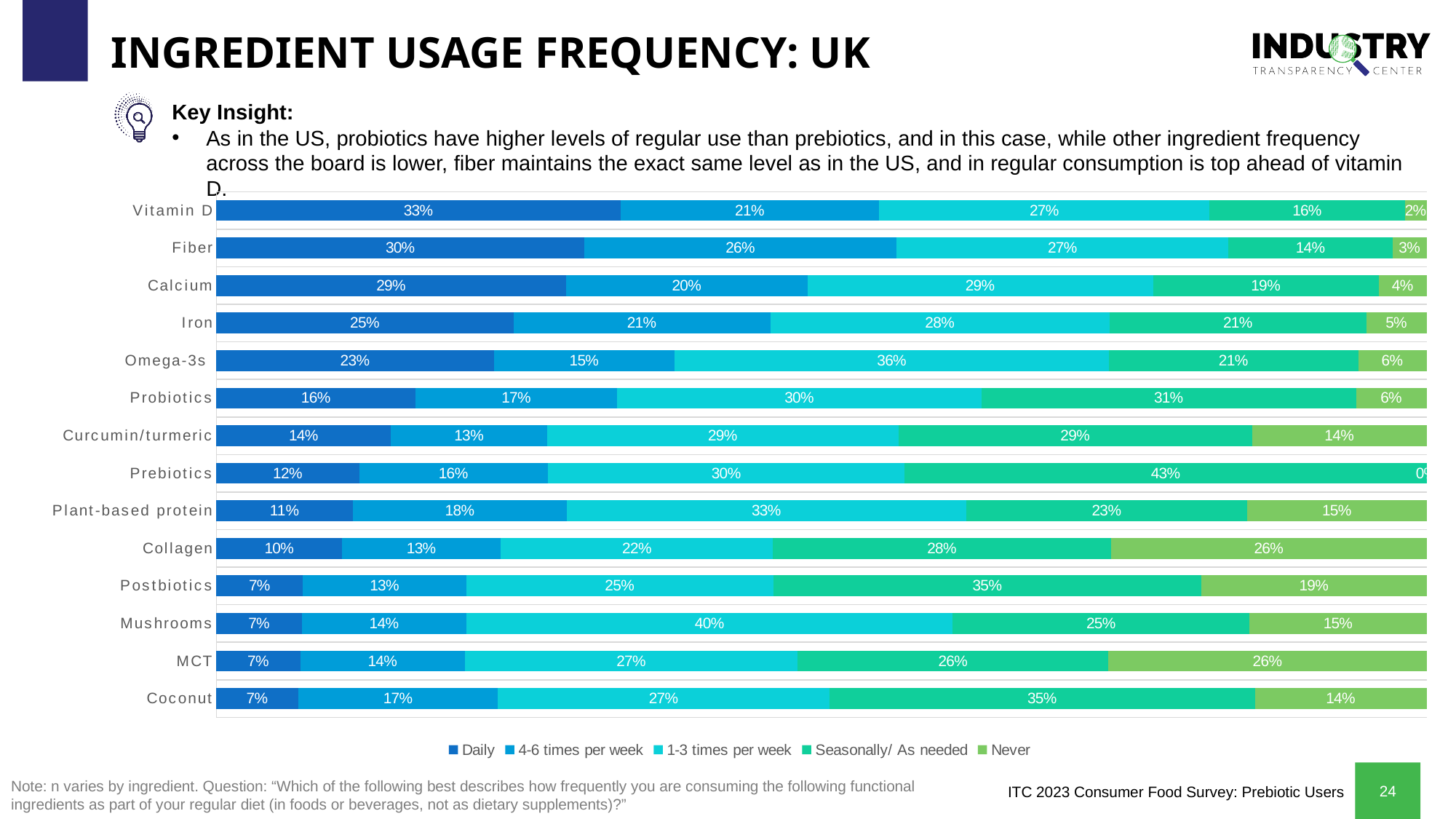
How many series does the legend list? 5 What percentage of respondents consume Vitamin D daily? 33% What is the difference between the 'Daily' values for Fiber and Probiotics? 14% How many ingredients are shown in the chart? 14 Which has a larger '4-6 times per week' value, Fiber or Calcium? Fiber What percentage of respondents consume Mushrooms 1-3 times per week? 40% What is the 'Seasonally/ As needed' value for Prebiotics? 43% What type of chart is shown on the slide? Stacked bar chart What is the 'Never' value for Collagen? 26% Which ingredient has the lowest 'Never' percentage? Prebiotics Which ingredient has the highest 'Daily' percentage? Vitamin D Which legend entry is shown in the darkest blue colour? Daily